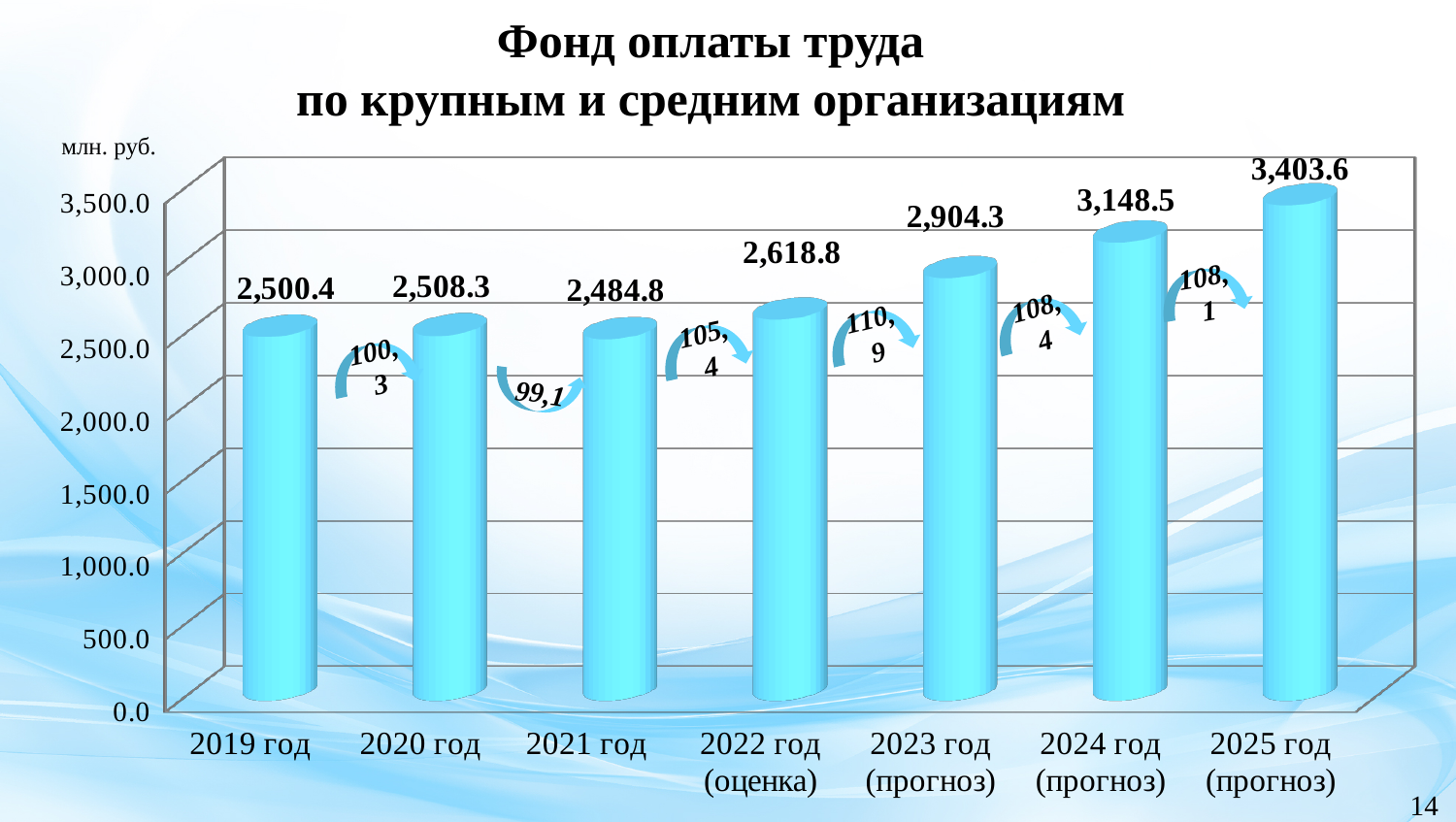
What is the value for 2024 год (прогноз)? 3,148.5 Which year has the lowest value? 2021 год What is the value for 2022 год (оценка)? 2,618.8 Is the value for 2023 год (прогноз) greater or less than 3,000.0? less Which year has the highest value? 2025 год (прогноз) What is the difference between the values for 2025 год (прогноз) and 2024 год (прогноз)? 255.1 Which is larger, the value for 2020 год or the value for 2021 год? 2020 год What unit is shown above the vertical axis? млн. руб. What kind of chart is this? bar chart What is the value for 2019 год? 2,500.4 What is the difference between the values for 2023 год (прогноз) and 2022 год (оценка)? 285.5 How many years are shown on the x axis? 7